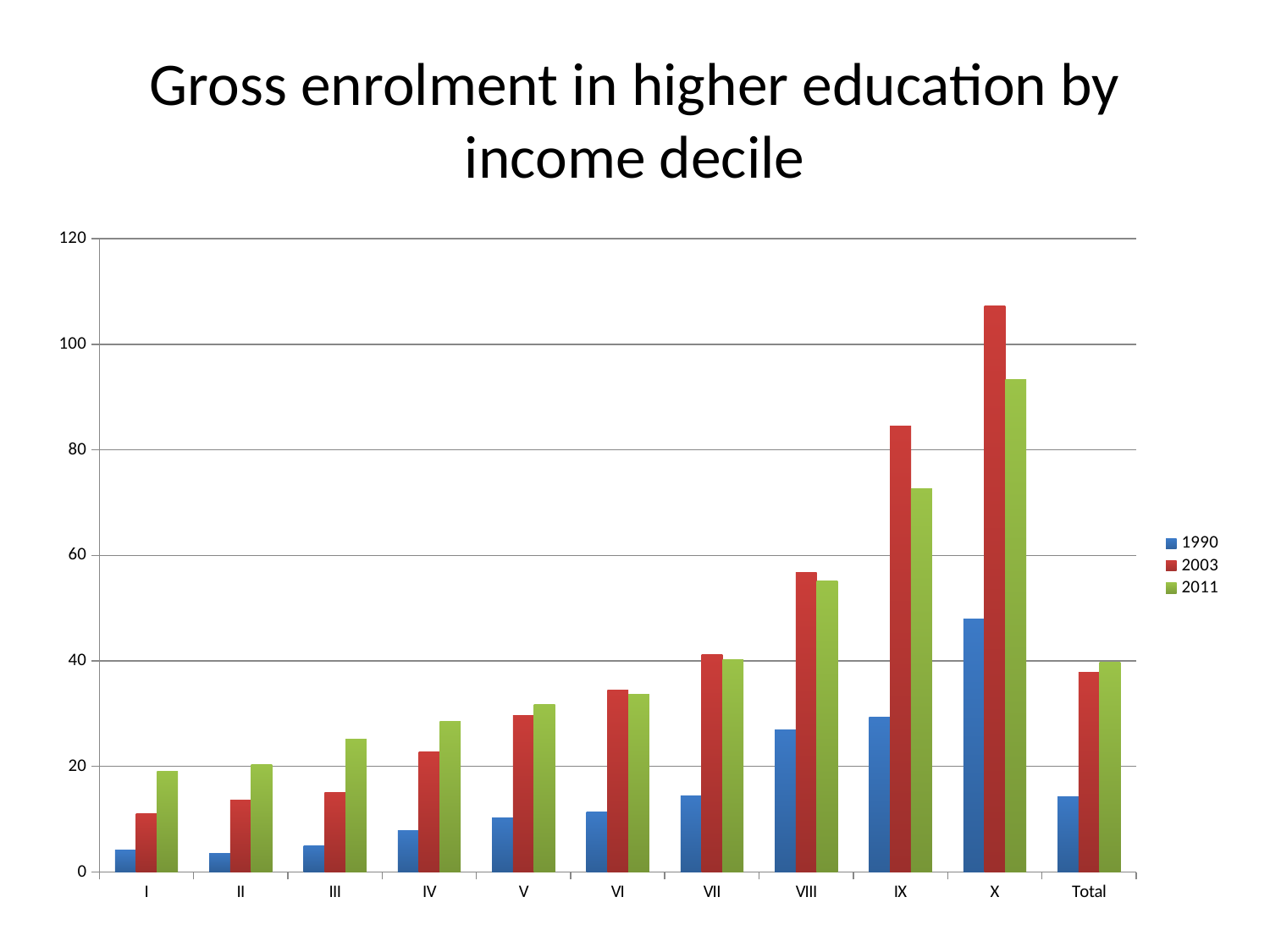
Is the 1990 value for decile X greater or less than 40? greater Is the 2011 value for decile X greater or less than 100? less Do the 1990 values rise or fall from decile I to decile X? rise What kind of chart is shown on the slide? bar chart Which category has the highest value for the 2003 series? X Is the 2003 value for decile X greater or less than 100? greater For decile IX, which series has the larger value, 2003 or 2011? 2003 How many series does the legend list? 3 Which income decile has the lowest value for the 2003 series? I How many categories are shown along the x axis? 11 For decile IV, which series has the larger value, 2003 or 2011? 2011 What are the entries listed in the legend? 1990, 2003, 2011